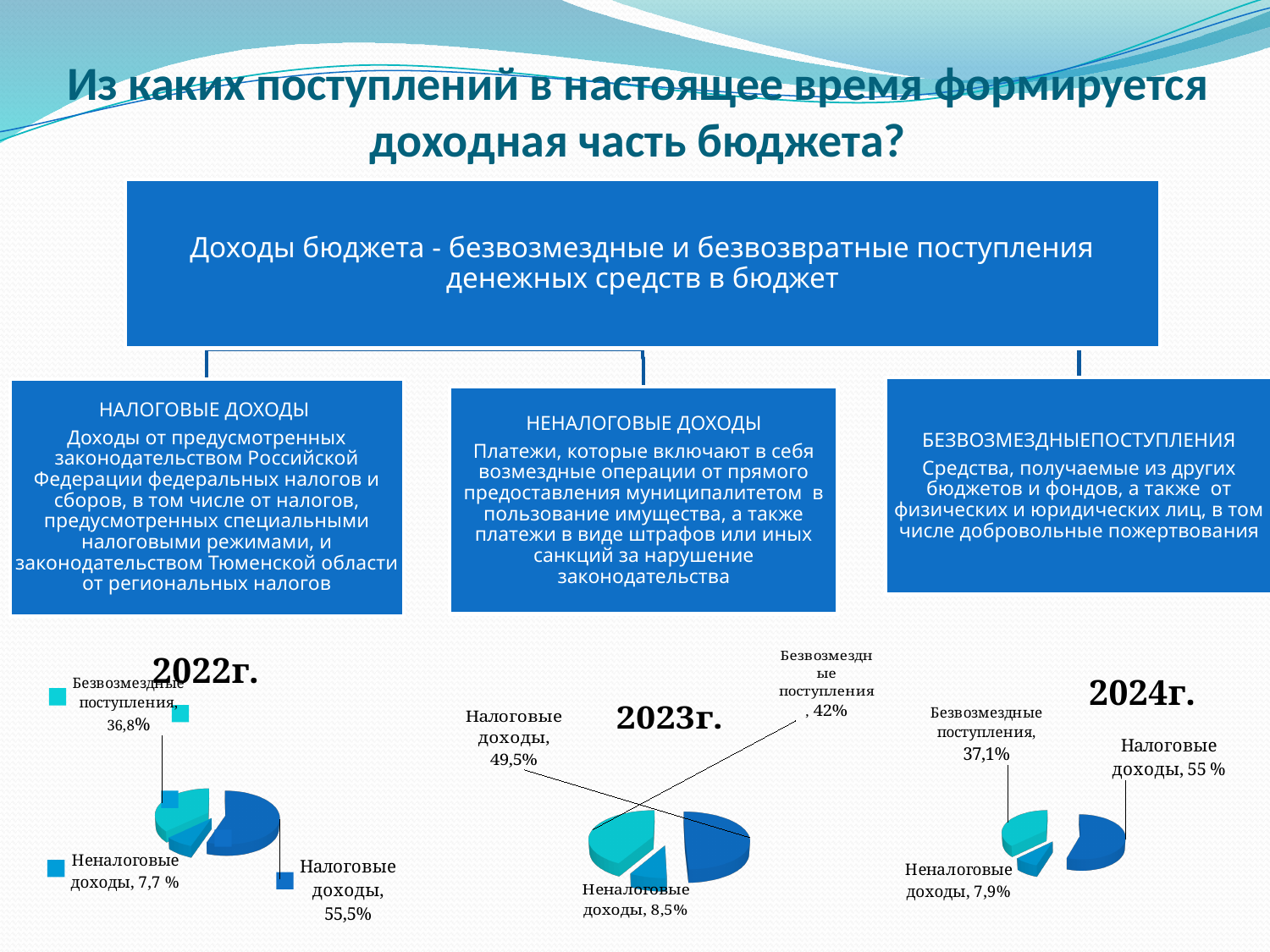
In the 2023г. chart, what share is shown for Неналоговые доходы? 8,5% How many slices does the 2024г. pie chart have? 3 In the 2023г. chart, what share is shown for Безвозмездные поступления? 42% In the 2024г. chart, which is larger: Безвозмездные поступления or Неналоговые доходы? Безвозмездные поступления In the 2022г. chart, which category has the smallest share? Неналоговые доходы In the 2022г. chart, what share is shown for Налоговые доходы? 55,5% In the 2023г. chart, which category has the largest share? Налоговые доходы In the 2022г. chart, what share is shown for Безвозмездные поступления? 36,8% What type of chart is used for the 2022г. data? Pie chart In the 2023г. chart, what is the difference between the shares of Налоговые доходы and Безвозмездные поступления? 7,5% In the 2024г. chart, what share is shown for Налоговые доходы? 55 % In the 2024г. chart, what share is shown for Неналоговые доходы? 7,9%